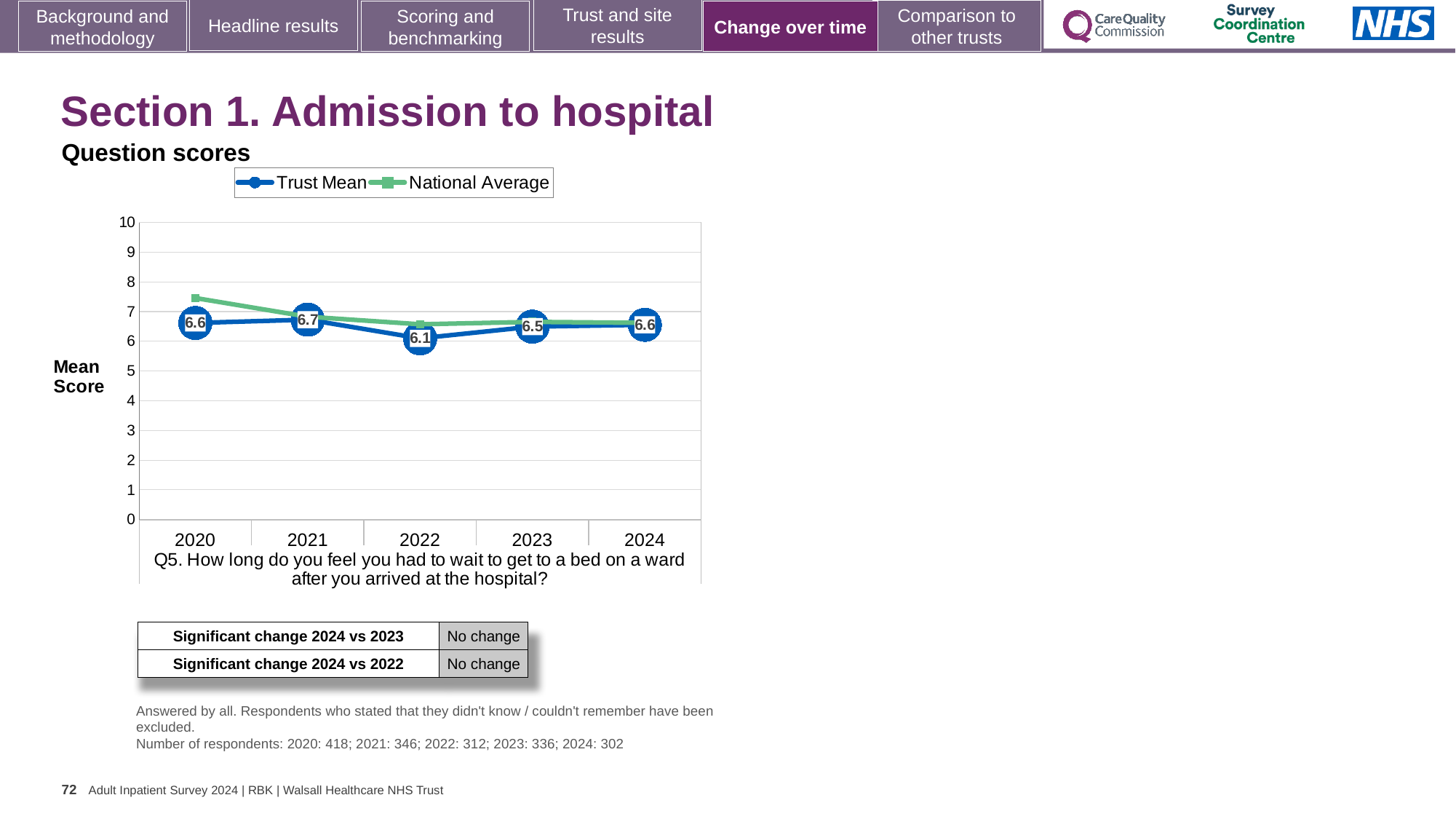
What is the Trust Mean score for 2024? 6.6 In which year is the Trust Mean score highest? 2021 What is the difference between the Trust Mean scores for 2021 and 2022? 0.6 Is the National Average value for 2020 greater or less than 7? greater What is the Trust Mean score for 2022? 6.1 Does the Trust Mean score rise or fall from 2021 to 2022? Fall What kind of chart is shown on the slide? Line chart How many years are plotted on the x axis? 5 How many series does the legend list? 2 In which year is the Trust Mean score lowest? 2022 What is the Trust Mean score for 2021? 6.7 Which is larger, the Trust Mean score for 2020 or for 2022? 2020